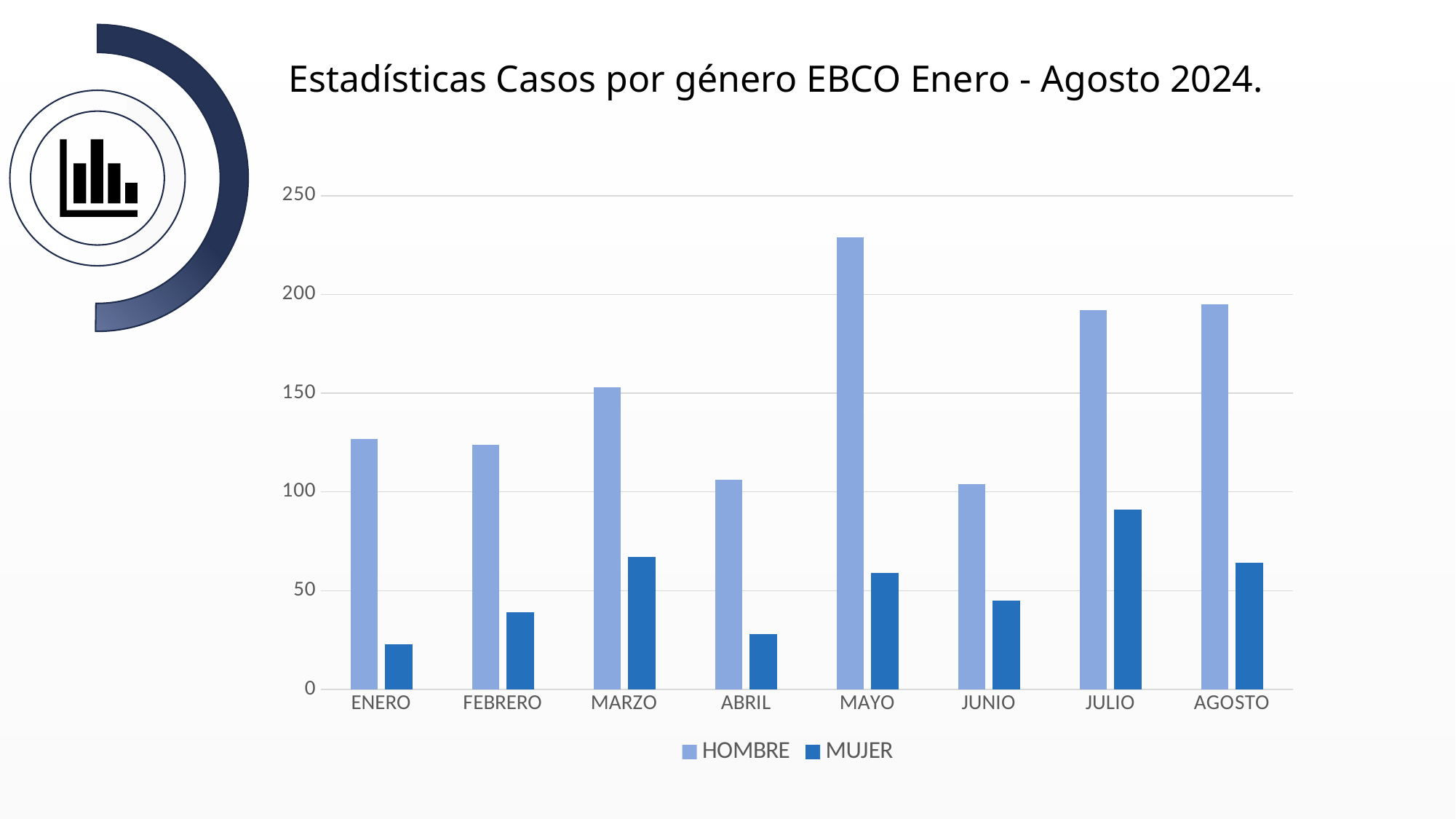
Is the HOMBRE value for MAYO greater or less than 200? greater Which month has the highest HOMBRE value? MAYO Which is larger, the MUJER value for MAYO or the MUJER value for ENERO? MAYO What kind of chart is shown on the slide? bar chart Is the MUJER value for JULIO greater or less than 100? less Which month has the highest MUJER value? JULIO How many months are shown on the x axis? 8 How many series does the legend list? 2 What is the title of the chart? Estadísticas Casos por género EBCO Enero - Agosto 2024. Which is larger, the HOMBRE value for MARZO or the HOMBRE value for ABRIL? MARZO Is the MUJER value for MARZO greater or less than 50? greater